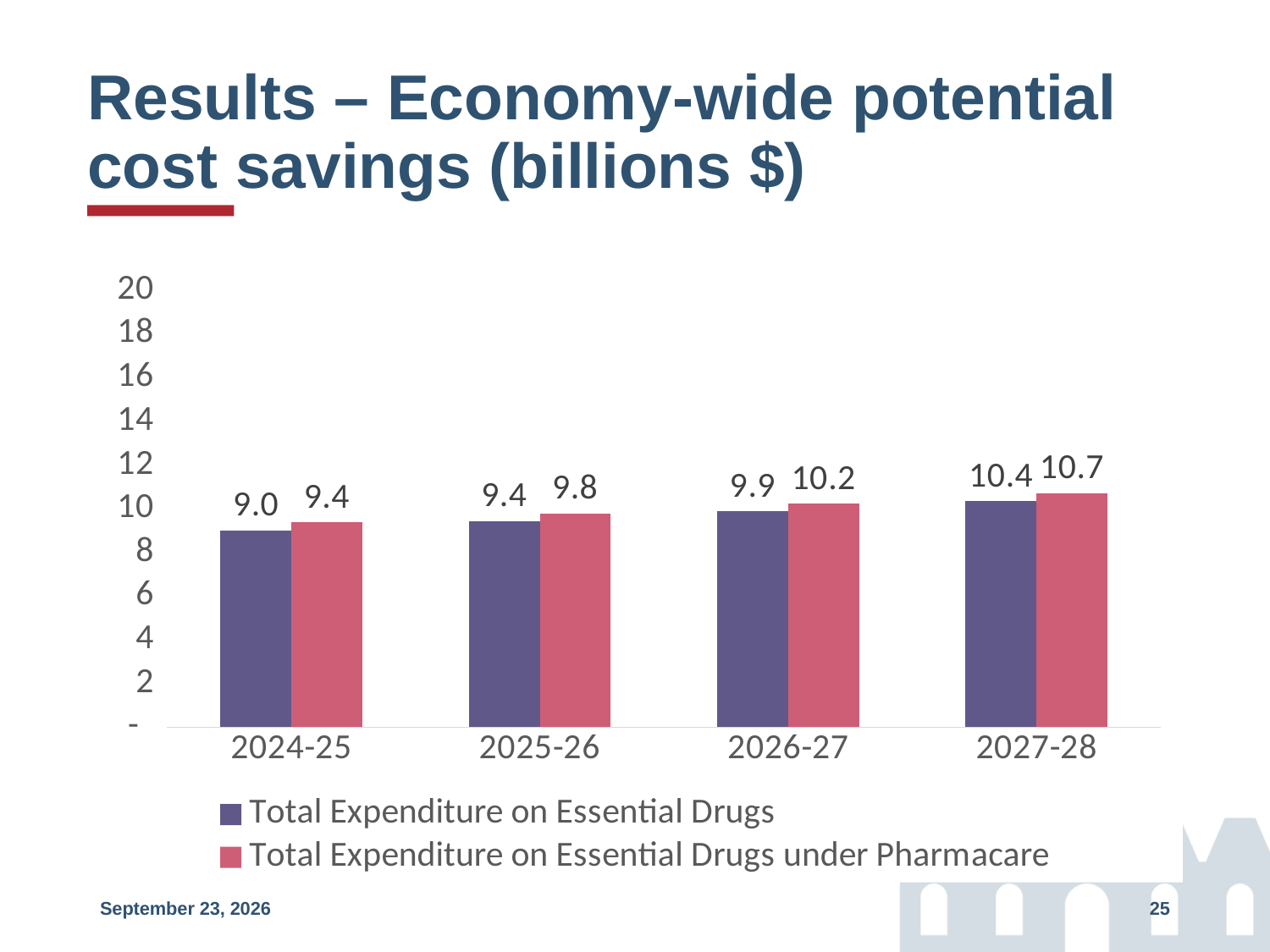
Do the values for Total Expenditure on Essential Drugs rise or fall from 2024-25 to 2027-28? rise What is the value of Total Expenditure on Essential Drugs under Pharmacare for 2026-27? 10.2 What is the difference between Total Expenditure on Essential Drugs under Pharmacare and Total Expenditure on Essential Drugs in 2025-26? 0.4 Is the value for Total Expenditure on Essential Drugs in 2026-27 greater or less than 12? less Which year has the highest value for Total Expenditure on Essential Drugs under Pharmacare? 2027-28 How many series does the legend list? 2 What is the value of Total Expenditure on Essential Drugs for 2024-25? 9.0 What is the value of Total Expenditure on Essential Drugs for 2027-28? 10.4 Which year has the lowest value for Total Expenditure on Essential Drugs? 2024-25 How many years are shown on the x axis? 4 In 2027-28, which is larger: Total Expenditure on Essential Drugs or Total Expenditure on Essential Drugs under Pharmacare? Total Expenditure on Essential Drugs under Pharmacare What kind of chart is shown on the slide? bar chart